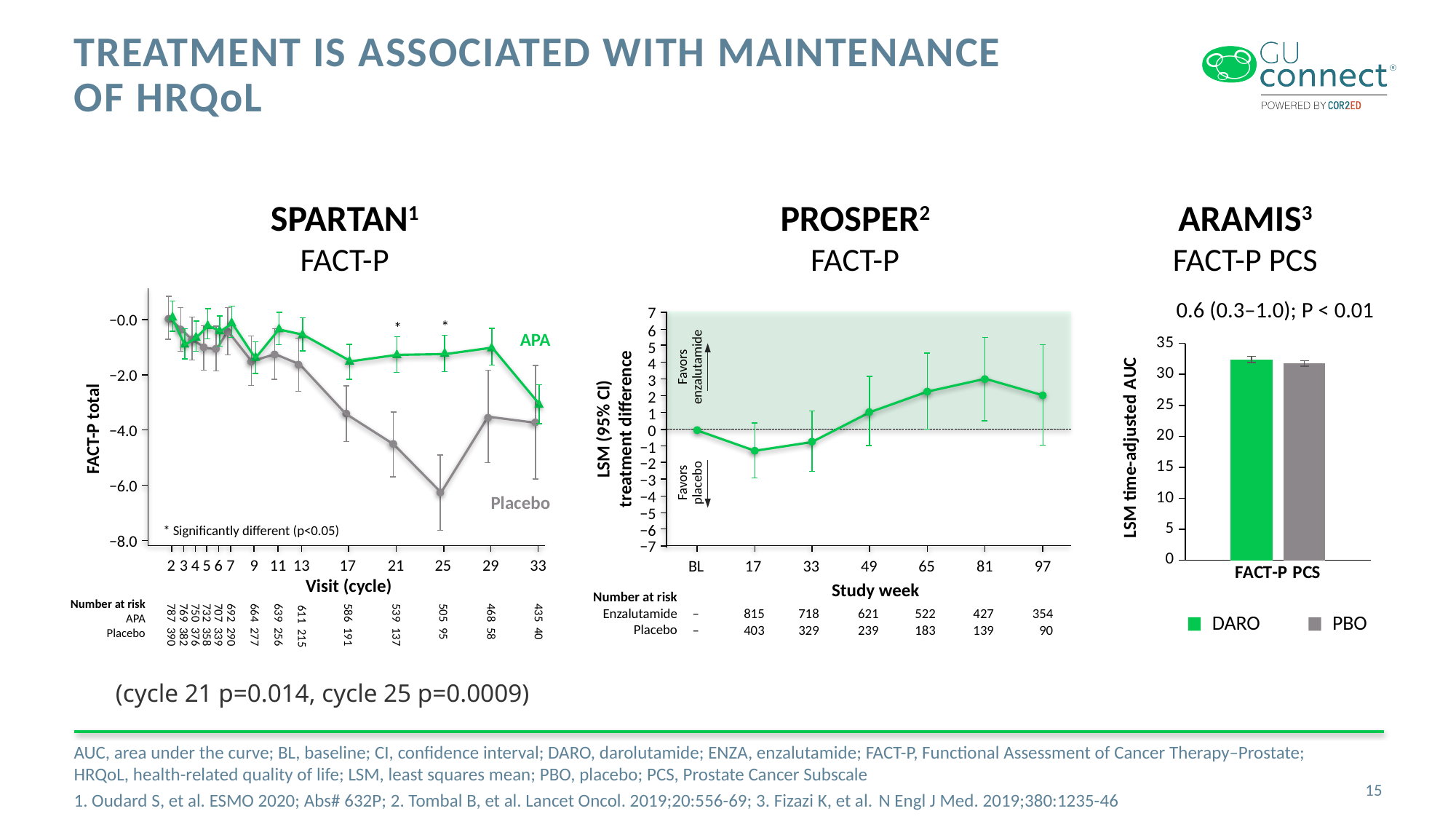
In the PROSPER chart, what is the number at risk for Enzalutamide at week 17? 815 In the SPARTAN chart, what is the number at risk for APA at cycle 33? 435 In the ARAMIS chart, is the value for DARO greater or less than 30? greater In the SPARTAN chart, at cycle 25, which group has the higher FACT-P total, APA or Placebo? APA In the PROSPER chart, how many study week time points are plotted? 7 In the PROSPER chart, is the LSM treatment difference at week 17 greater or less than 0? less In the ARAMIS chart, how many series does the legend list? 2 What kind of chart is the SPARTAN FACT-P chart? Line chart In the SPARTAN chart, does the Placebo line rise or fall from cycle 2 to cycle 25? Fall In the PROSPER chart, what is the number at risk for Placebo at week 97? 90 What kind of chart is the ARAMIS chart? Bar chart In the PROSPER chart, is the LSM treatment difference at week 81 greater or less than 2? greater